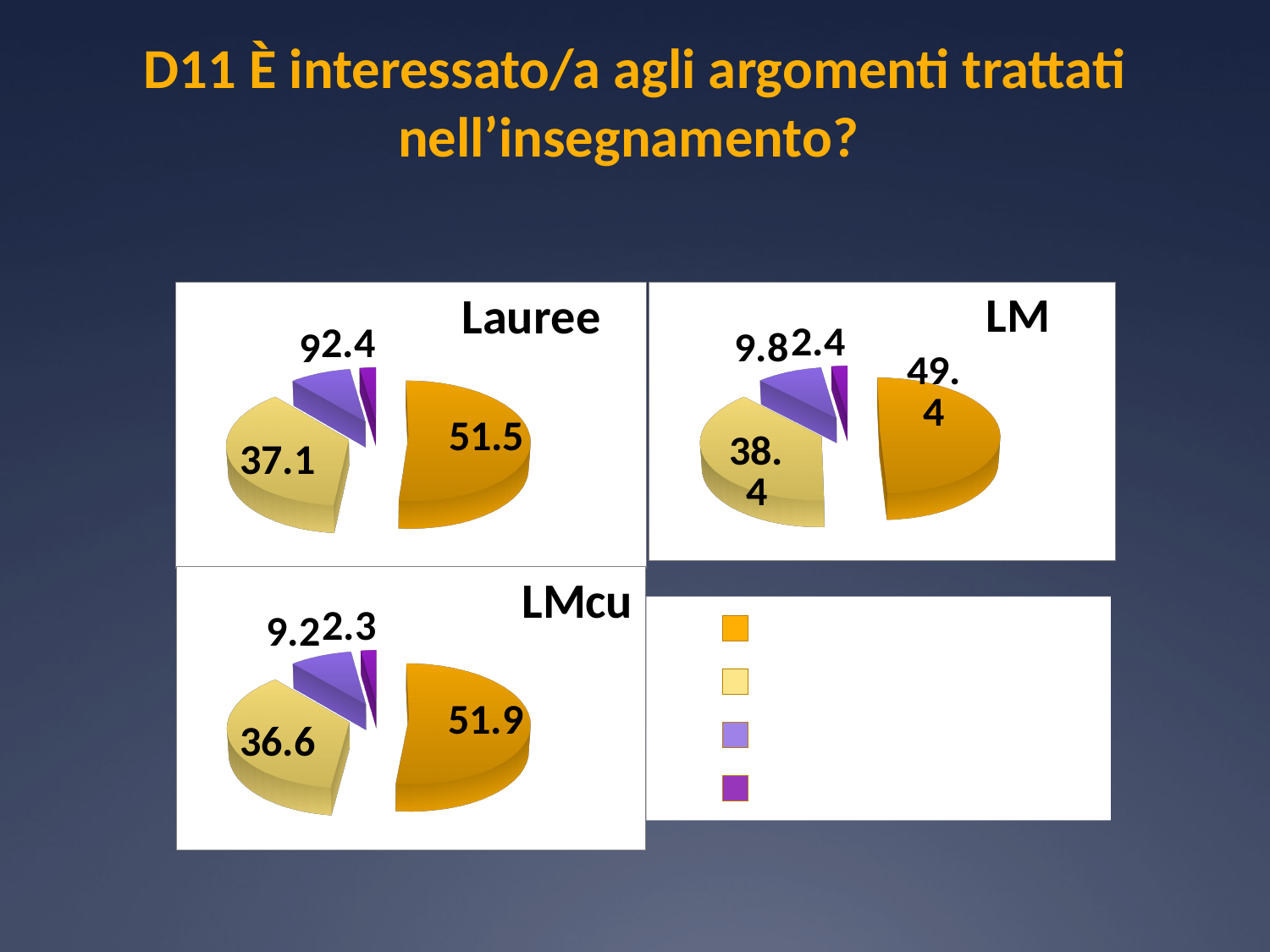
In the LMcu chart, what is the value of the dark purple slice? 2.3 In the LMcu chart, which slice is the largest? the orange slice (51.9) How many pie charts are shown on the slide? 3 How many slices does the LM pie chart have? 4 In the LM chart, what is the value of the orange slice? 49.4 What kind of chart is the Lauree chart? pie chart Which is larger: the orange slice in the Lauree chart or the orange slice in the LM chart? the Lauree chart (51.5) In the LM chart, which slice is the smallest? the dark purple slice (2.4) In the Lauree chart, what is the value of the light yellow slice? 37.1 In the LM chart, what is the value of the light purple slice? 9.8 In the Lauree chart, what is the value of the orange slice? 51.5 In the LMcu chart, what is the difference between the orange slice and the light yellow slice? 15.3